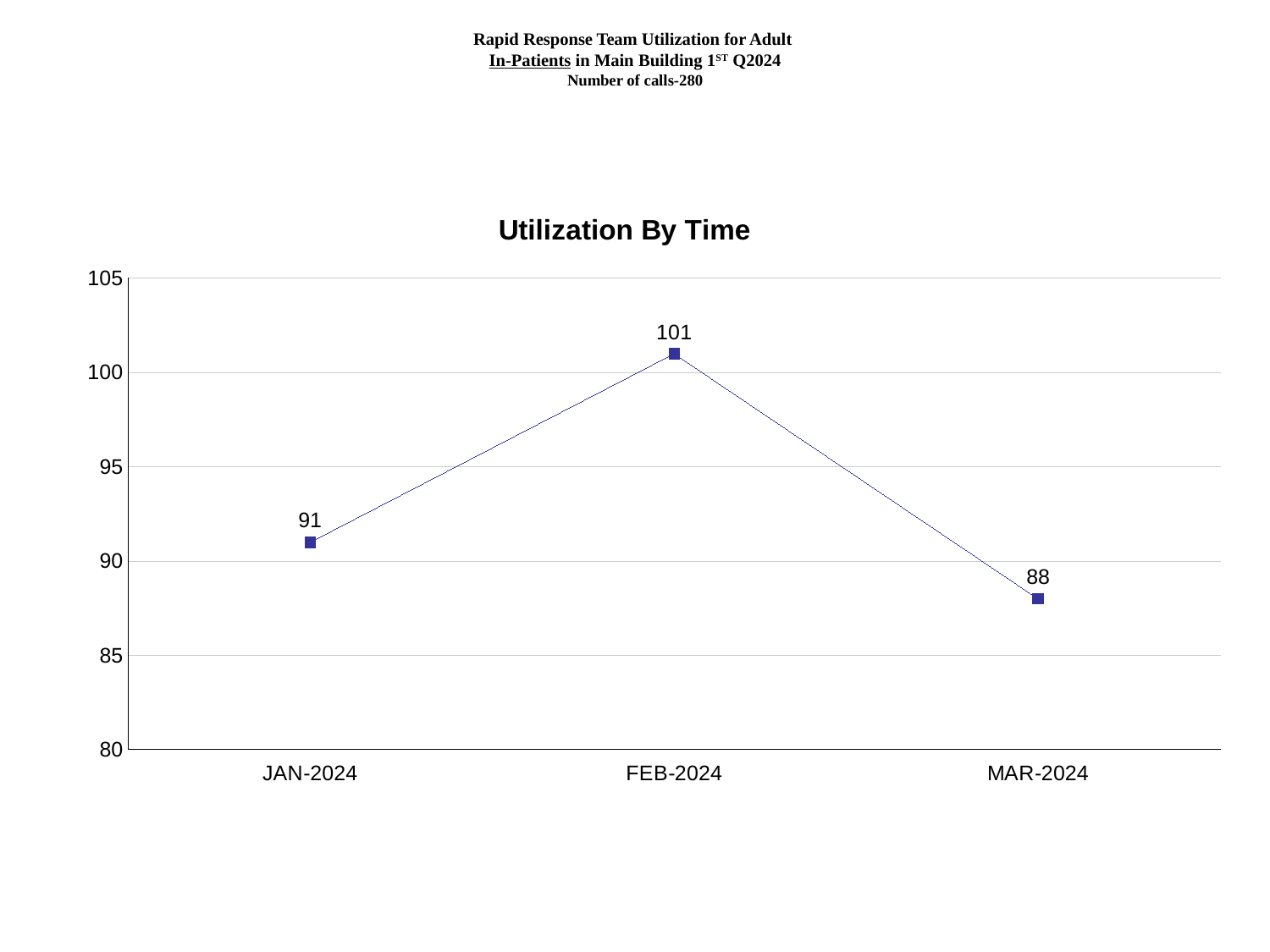
What is the value for JAN-2024? 91 Which month has the highest value? FEB-2024 What is the difference between the values for JAN-2024 and MAR-2024? 3 What kind of chart is shown? line chart What is the value for FEB-2024? 101 Is the value for FEB-2024 greater or less than 100? greater Which is larger, the value for JAN-2024 or the value for MAR-2024? JAN-2024 What is the value for MAR-2024? 88 How many months are plotted on the chart? 3 Which month has the lowest value? MAR-2024 What is the title of the chart? Utilization By Time What is the difference between the values for FEB-2024 and JAN-2024? 10